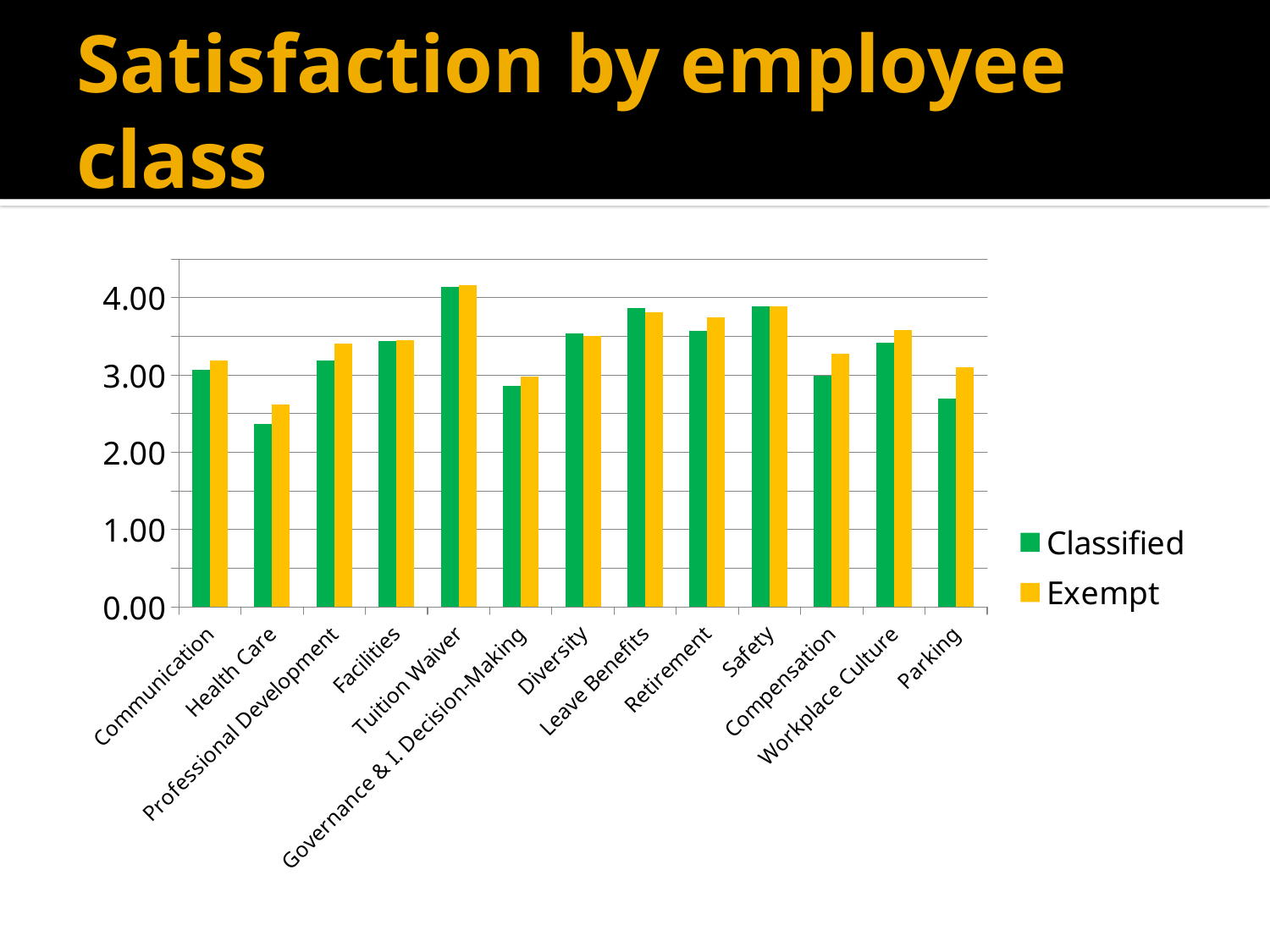
Which category has the lowest Exempt value? Health Care How many series does the legend list? 2 Is the Classified value for Parking greater or less than 3.00? less Is the Classified value for Health Care greater or less than 3.00? less For Parking, which series has the larger value, Classified or Exempt? Exempt Which category has the lowest Classified value? Health Care What colour are the Exempt bars? Yellow Which category has the highest Classified value? Tuition Waiver Is the Exempt value for Compensation greater or less than 3.00? greater How many categories are shown on the x axis? 13 What kind of chart is shown on the slide? Bar chart